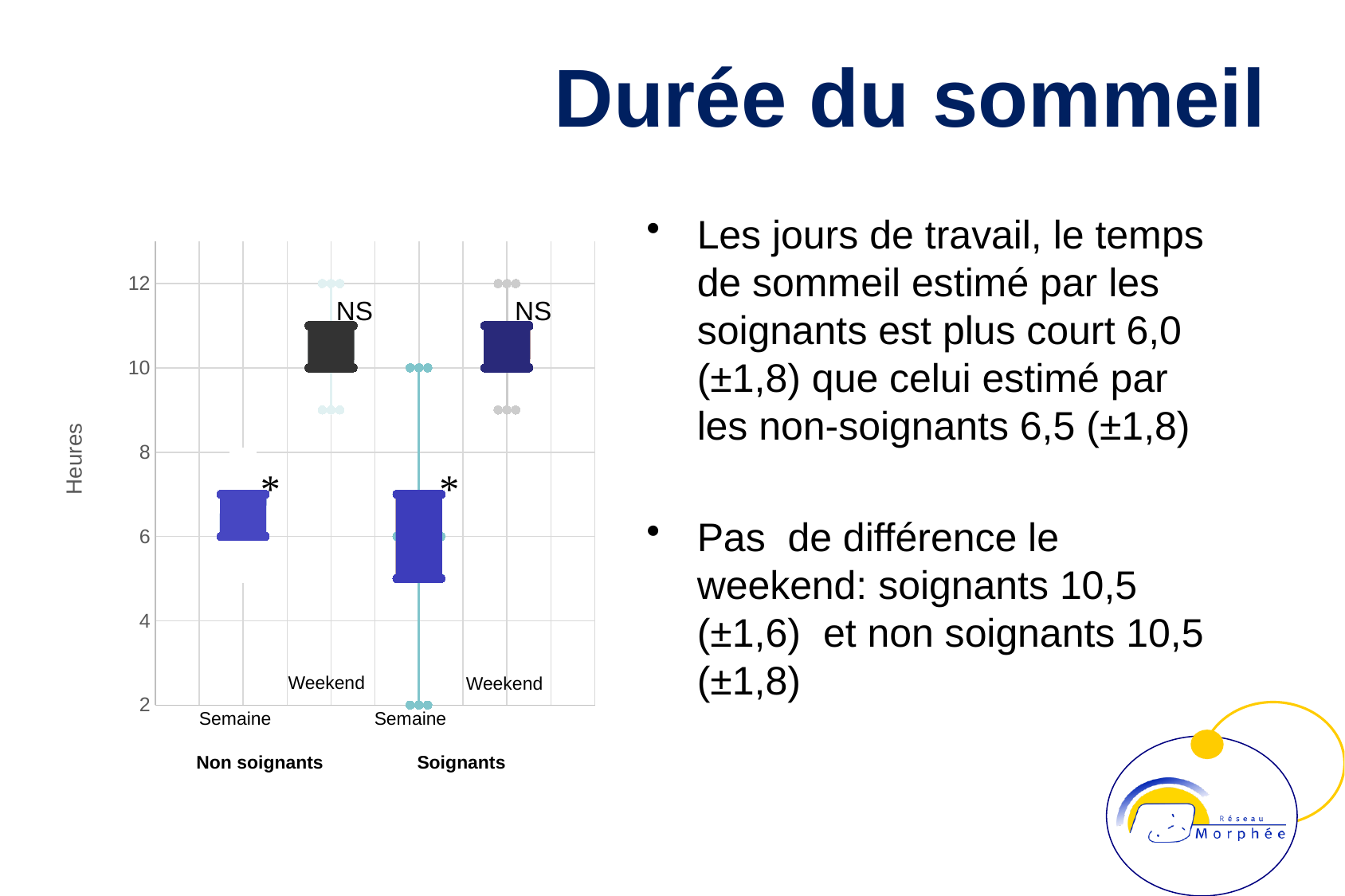
What is the label of the y axis of the chart? Heures Is the Semaine box for Non soignants greater or less than 8 hours? less For Non soignants, which is higher on the chart: the Semaine box or the Weekend box? Weekend What annotation is written above the two Weekend boxes? NS Is the Weekend box for Soignants greater or less than 8 hours? greater What are the two groups labelled along the bottom of the chart? Non soignants and Soignants For Soignants, which is higher on the chart: the Semaine box or the Weekend box? Weekend Within each group, do the values rise or fall from Semaine to Weekend? rise How many boxes are plotted in the chart? 4 Is the Semaine box for Soignants greater or less than 8 hours? less What kind of chart is shown on the slide? Box plot